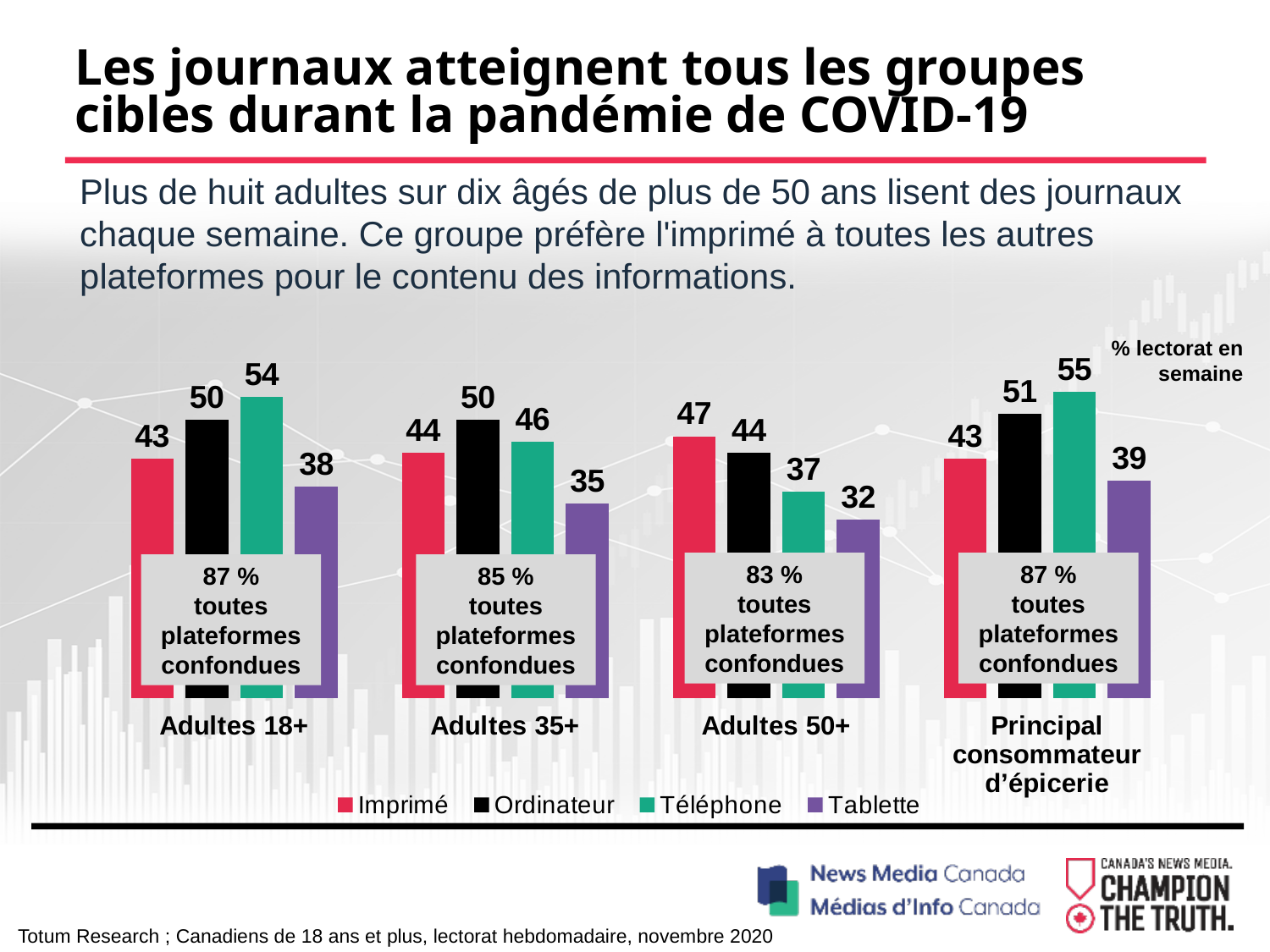
What is the difference between Téléphone and Tablette in the Adultes 18+ group? 16 Which platform has the lowest value in the Adultes 35+ group? Tablette How many groups (categories) are shown on the x axis? 4 Which colour represents Téléphone in the legend? Green What is the 'toutes plateformes confondues' percentage shown for the Adultes 50+ group? 83 % What is the value for Imprimé in the Adultes 18+ group? 43 How many series does the legend list? 4 Which platform has the highest value in the Adultes 50+ group? Imprimé What is the value for Tablette in the Adultes 50+ group? 32 What is the value for Téléphone in the Principal consommateur d'épicerie group? 55 What kind of chart is shown on the slide? Bar chart Which is larger in the Adultes 35+ group, Ordinateur or Téléphone? Ordinateur